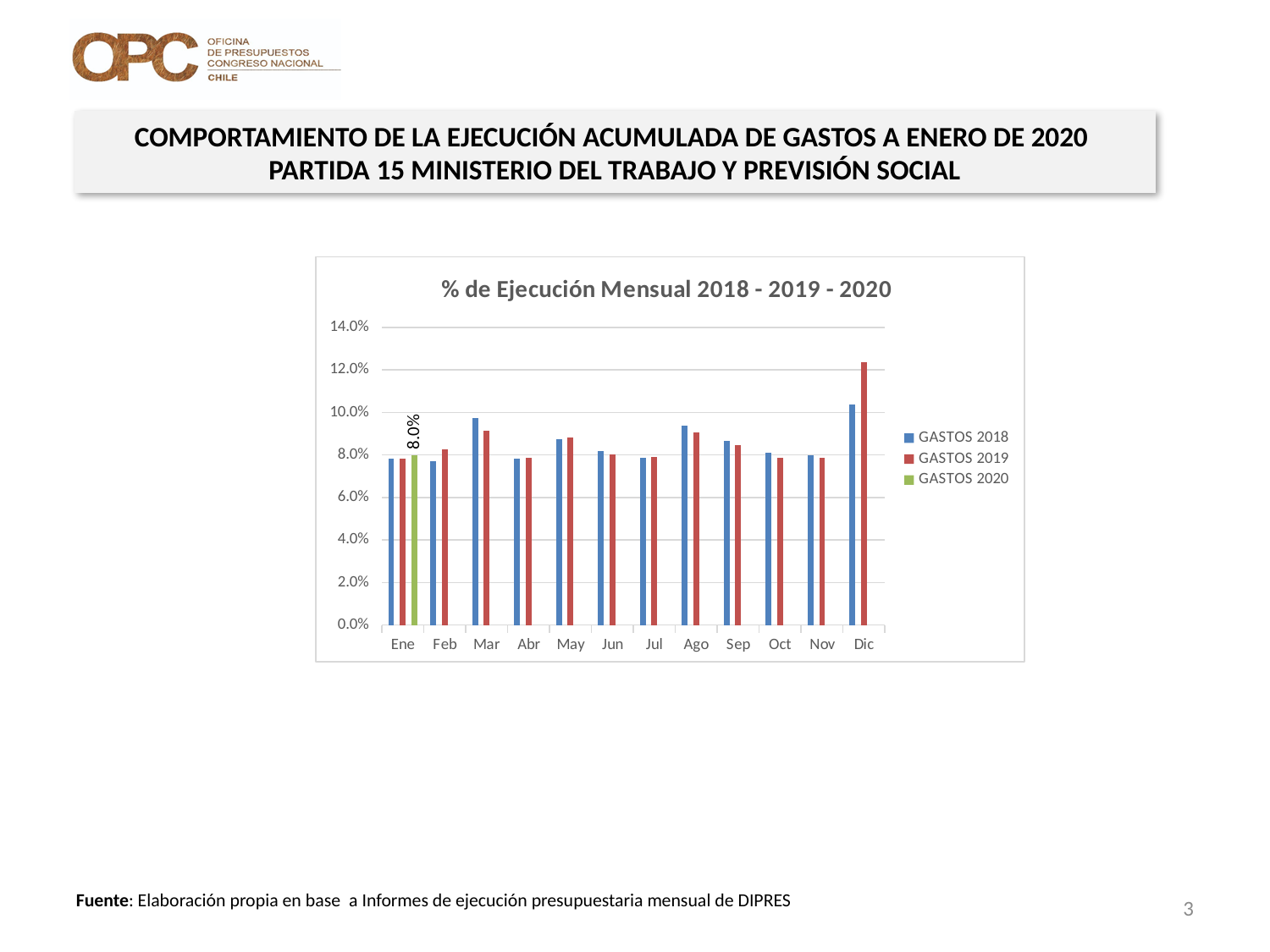
In Mar, which series has the larger value, GASTOS 2018 or GASTOS 2019? GASTOS 2018 For how many months is a GASTOS 2020 bar plotted? 1 What is the value of GASTOS 2020 for Ene? 8.0% Is the GASTOS 2019 value for Dic greater or less than 12.0%? greater In which month is the GASTOS 2018 value highest? Dic What is the title of the chart? % de Ejecución Mensual 2018 - 2019 - 2020 What kind of chart is shown on the slide? Bar chart How many months are shown on the x axis of the chart? 12 In Dic, which series has the larger value, GASTOS 2018 or GASTOS 2019? GASTOS 2019 Is the GASTOS 2018 value for Dic greater or less than 10.0%? greater How many series does the legend list? 3 In which month is the GASTOS 2019 value highest? Dic